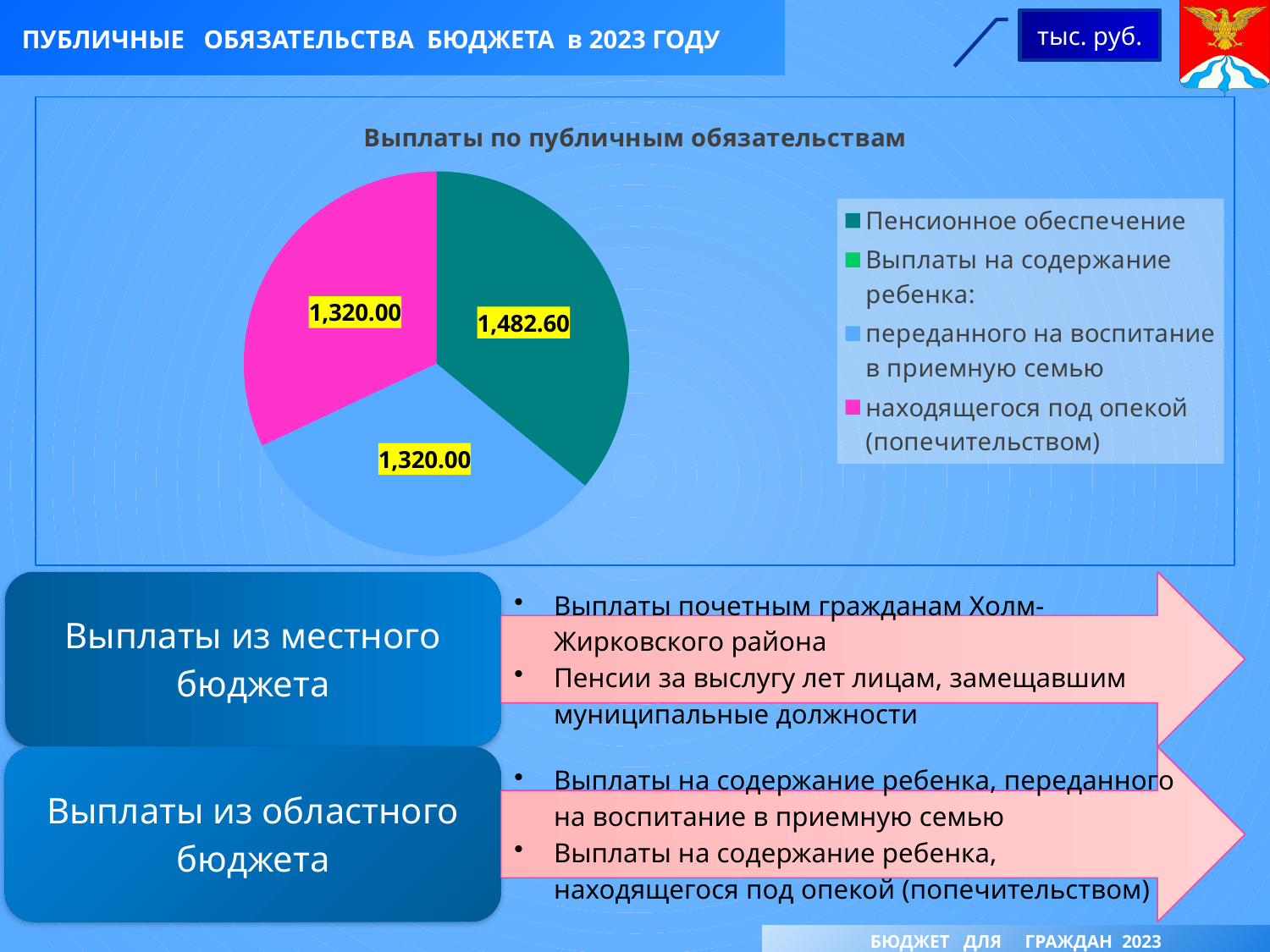
What is the difference between the value for Пенсионное обеспечение and the value for находящегося под опекой (попечительством)? 162.60 How many slices does the pie chart have? 3 How many entries does the legend list? 4 What type of chart is shown on the slide? Pie chart What is the total of all the slice values shown in the pie chart? 4,122.60 What is the value of the slice for находящегося под опекой (попечительством)? 1,320.00 What unit of measurement is indicated for the values on the slide? тыс. руб. What is the title of the chart? Выплаты по публичным обязательствам Which category has the largest slice in the pie chart? Пенсионное обеспечение What is the value of the slice for переданного на воспитание в приемную семью? 1,320.00 Which is larger: the value for Пенсионное обеспечение or the value for переданного на воспитание в приемную семью? Пенсионное обеспечение What is the value of the slice for Пенсионное обеспечение? 1,482.60